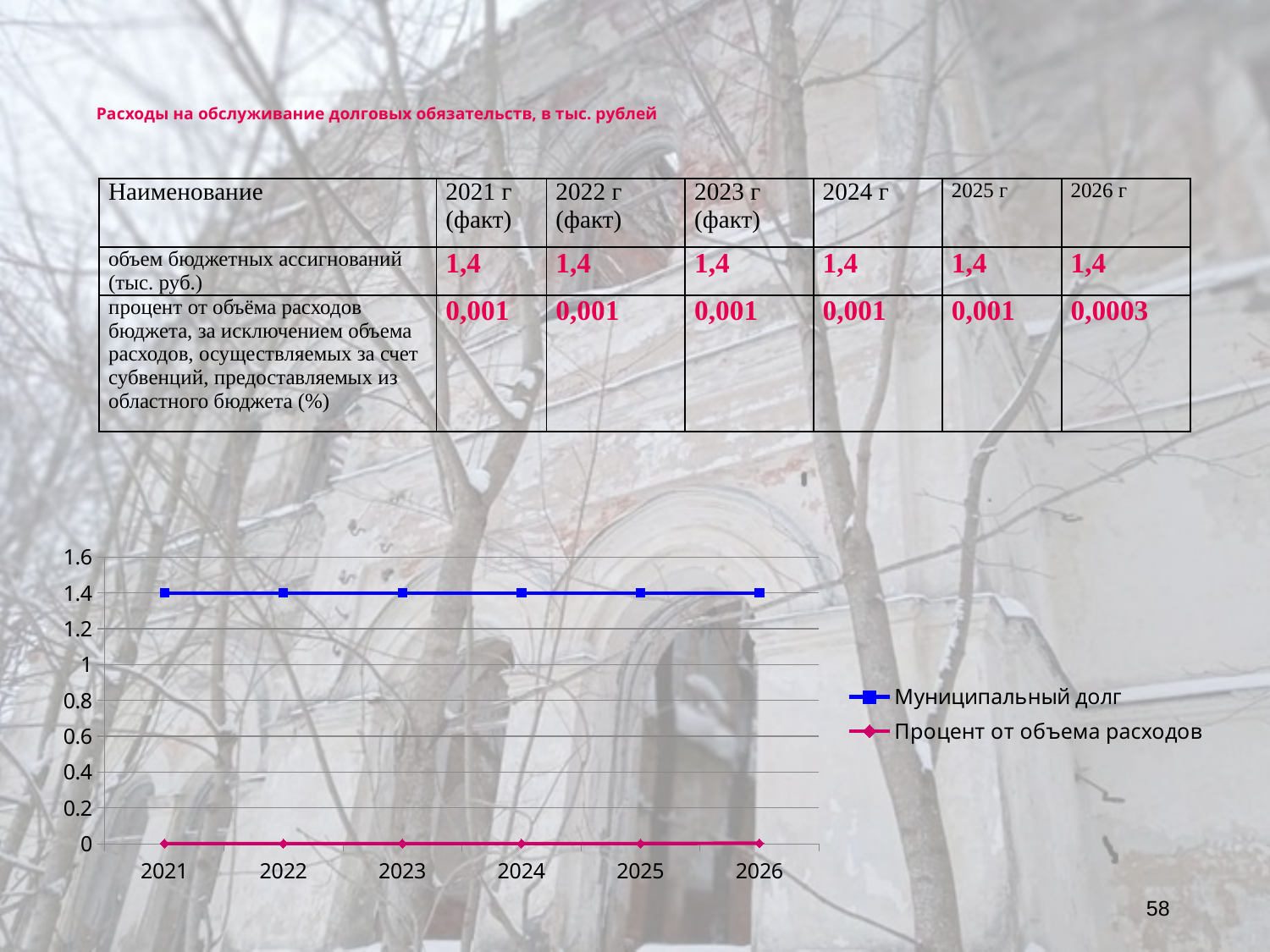
What is the value of the Муниципальный долг series in 2026? 1.4 Does the Муниципальный долг series rise, fall or stay flat from 2021 to 2026? stays flat What is the first year shown on the x axis of the chart? 2021 Which series is drawn in blue on the chart? Муниципальный долг How many years are plotted along the x axis of the chart? 6 Is the value of the Муниципальный долг series in 2023 greater or less than 1? greater What kind of chart is shown on the slide? line chart Which series has the higher value in 2025, Муниципальный долг or Процент от объема расходов? Муниципальный долг What is the highest value shown on the y axis of the chart? 1.6 Is the value of the Процент от объема расходов series in 2024 greater or less than 0.2? less What is the value of the Муниципальный долг series in 2021? 1.4 How many series does the chart legend list? 2